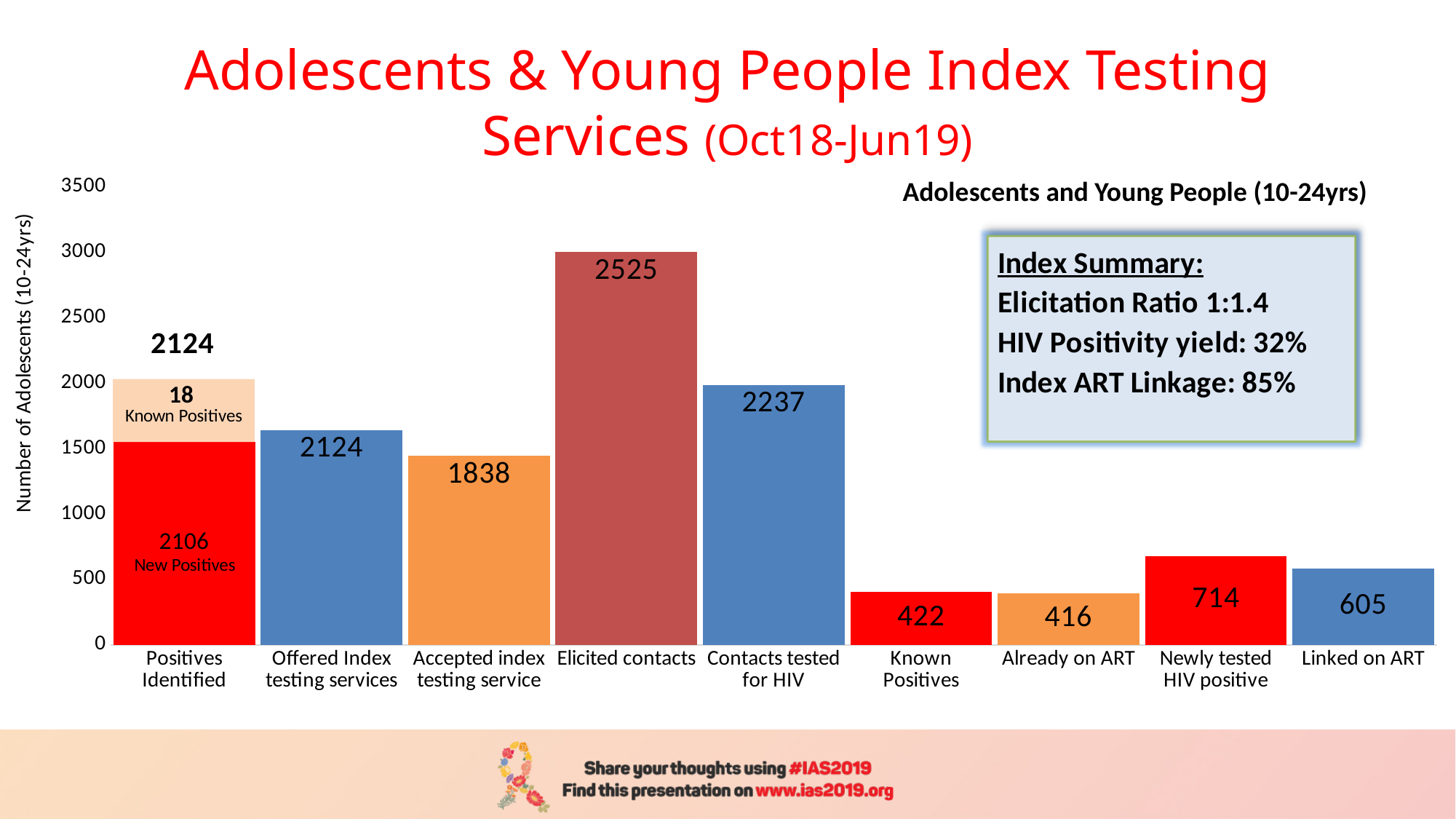
What is the value for Accepted index testing service? 1838 Which is larger, Newly tested HIV positive or Linked on ART? Newly tested HIV positive What is the value for Linked on ART? 605 How many Known Positives are shown within the Positives Identified bar? 18 What is the value for Contacts tested for HIV? 2237 What kind of chart is shown? Bar chart How many categories are shown on the x axis? 9 What is the difference between Offered Index testing services and Accepted index testing service? 286 Which category has the highest value? Elicited contacts What is the value for Elicited contacts? 2525 What is the difference between Newly tested HIV positive and Linked on ART? 109 What is the label on the vertical axis? Number of Adolescents (10-24yrs)